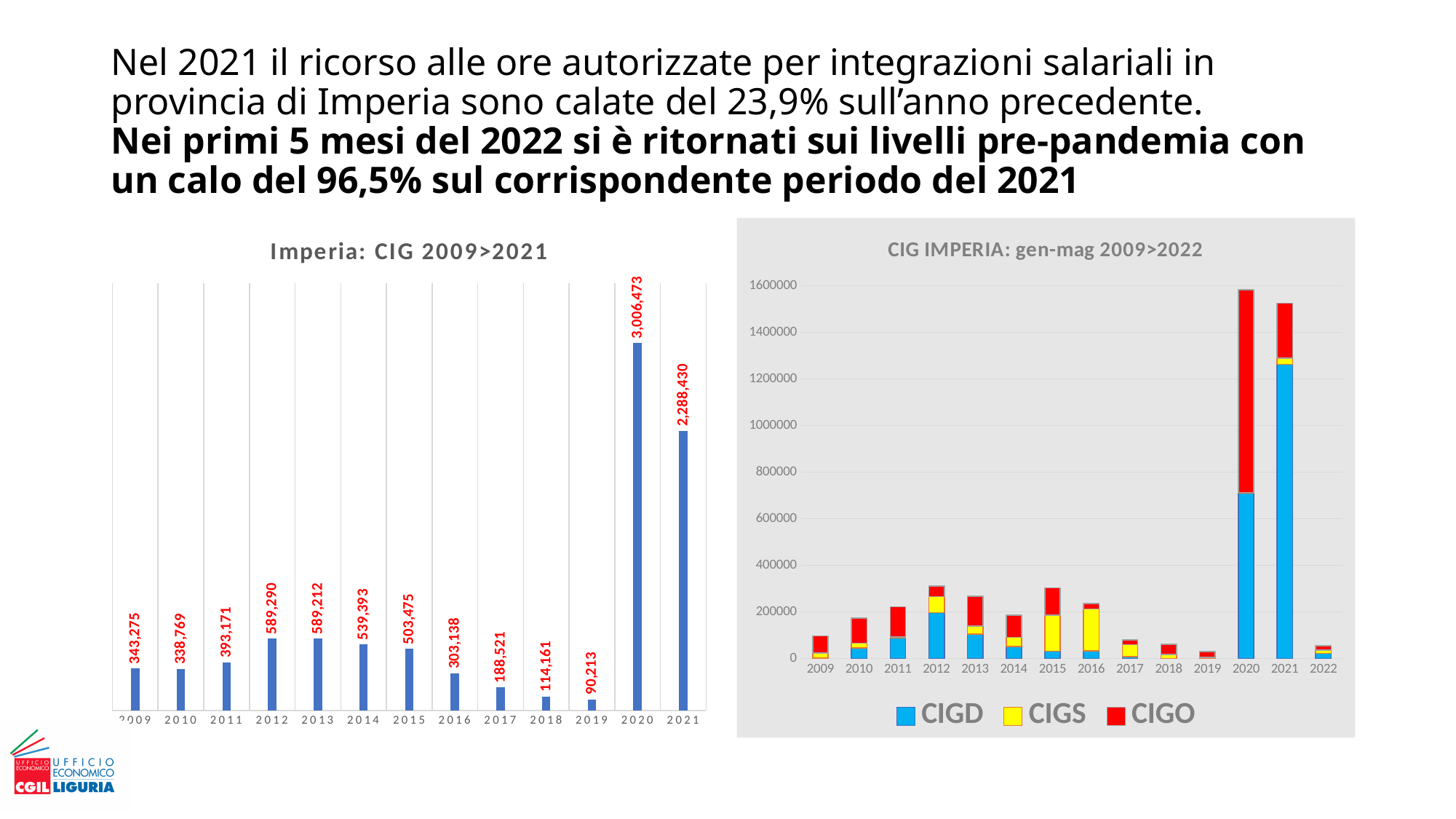
In the chart 'Imperia: CIG 2009>2021', which is larger, the value for 2014 or the value for 2015? 2014 What kind of chart is 'CIG IMPERIA: gen-mag 2009>2022'? stacked bar chart In the chart 'Imperia: CIG 2009>2021', which year has the lowest value? 2019 In the chart 'Imperia: CIG 2009>2021', which year has the highest value? 2020 In the chart 'CIG IMPERIA: gen-mag 2009>2022', how many series does the legend list? 3 In the chart 'Imperia: CIG 2009>2021', do the values rise or fall from 2016 to 2019? fall In the chart 'Imperia: CIG 2009>2021', what is the value for 2019? 90,213 In the chart 'Imperia: CIG 2009>2021', what is the difference between the values for 2020 and 2021? 718,043 In the chart 'Imperia: CIG 2009>2021', what is the value for 2021? 2,288,430 In the chart 'CIG IMPERIA: gen-mag 2009>2022', is the total of the stacked bar for 2019 greater or less than 200000? less In the chart 'CIG IMPERIA: gen-mag 2009>2022', is the total of the stacked bar for 2020 greater or less than 1400000? greater In the chart 'Imperia: CIG 2009>2021', how many years are shown on the x axis? 13